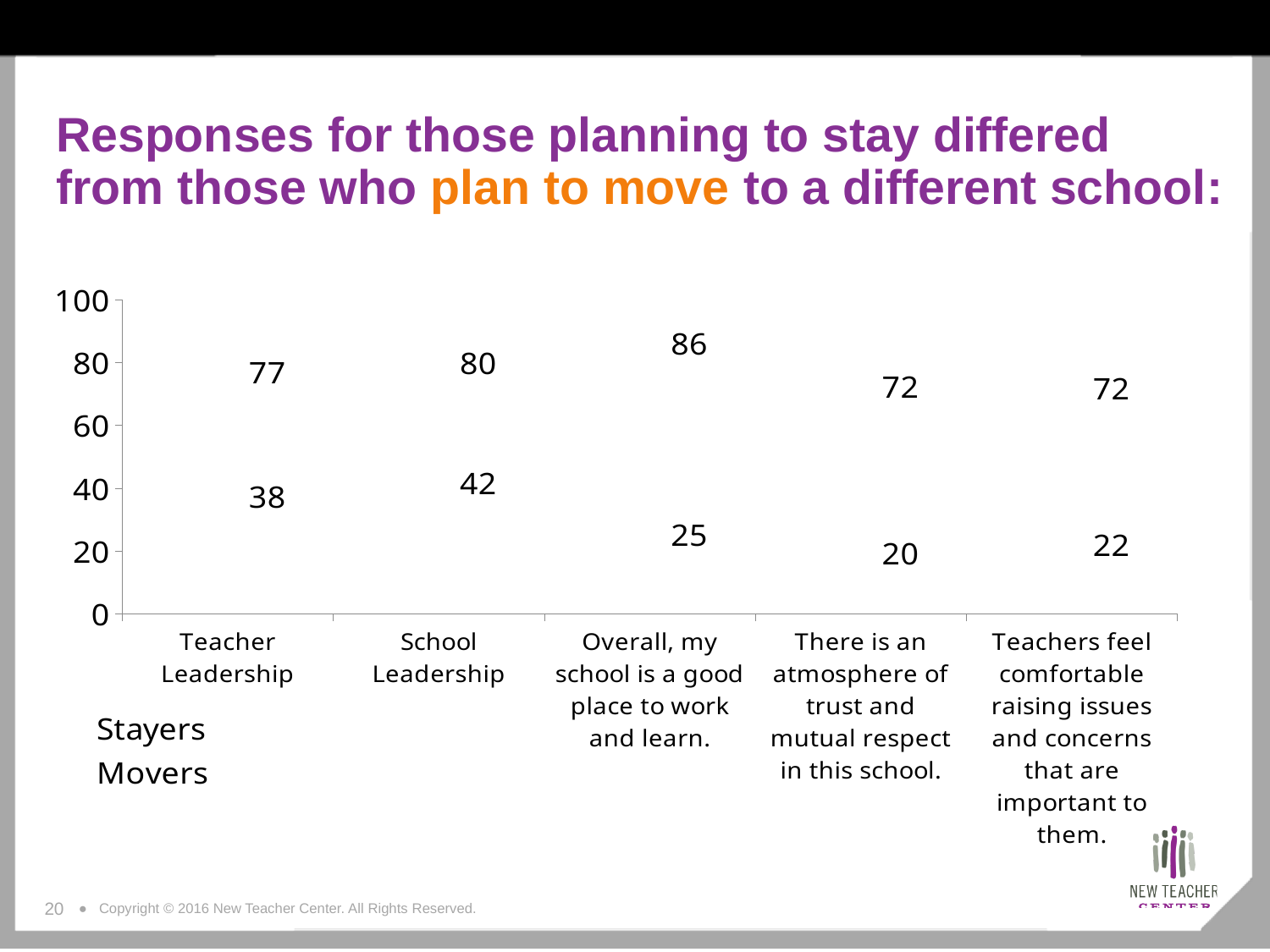
What is the higher of the two values shown for School Leadership? 80 How many categories are shown along the x axis of the chart? 5 What are the two series names listed in the chart's legend? Stayers and Movers How many series does the chart's legend list? 2 What is the lower of the two values shown for Teacher Leadership? 38 What is the highest value shown anywhere on the chart? 86 What is the lowest value shown anywhere on the chart? 20 What is the difference between the two values shown for School Leadership? 38 What is the lower of the two values shown for 'There is an atmosphere of trust and mutual respect in this school.'? 20 What is the higher of the two values shown for Teacher Leadership? 77 What is the lower of the two values shown for 'Overall, my school is a good place to work and learn.'? 25 What is the difference between the two values shown for 'Overall, my school is a good place to work and learn.'? 61